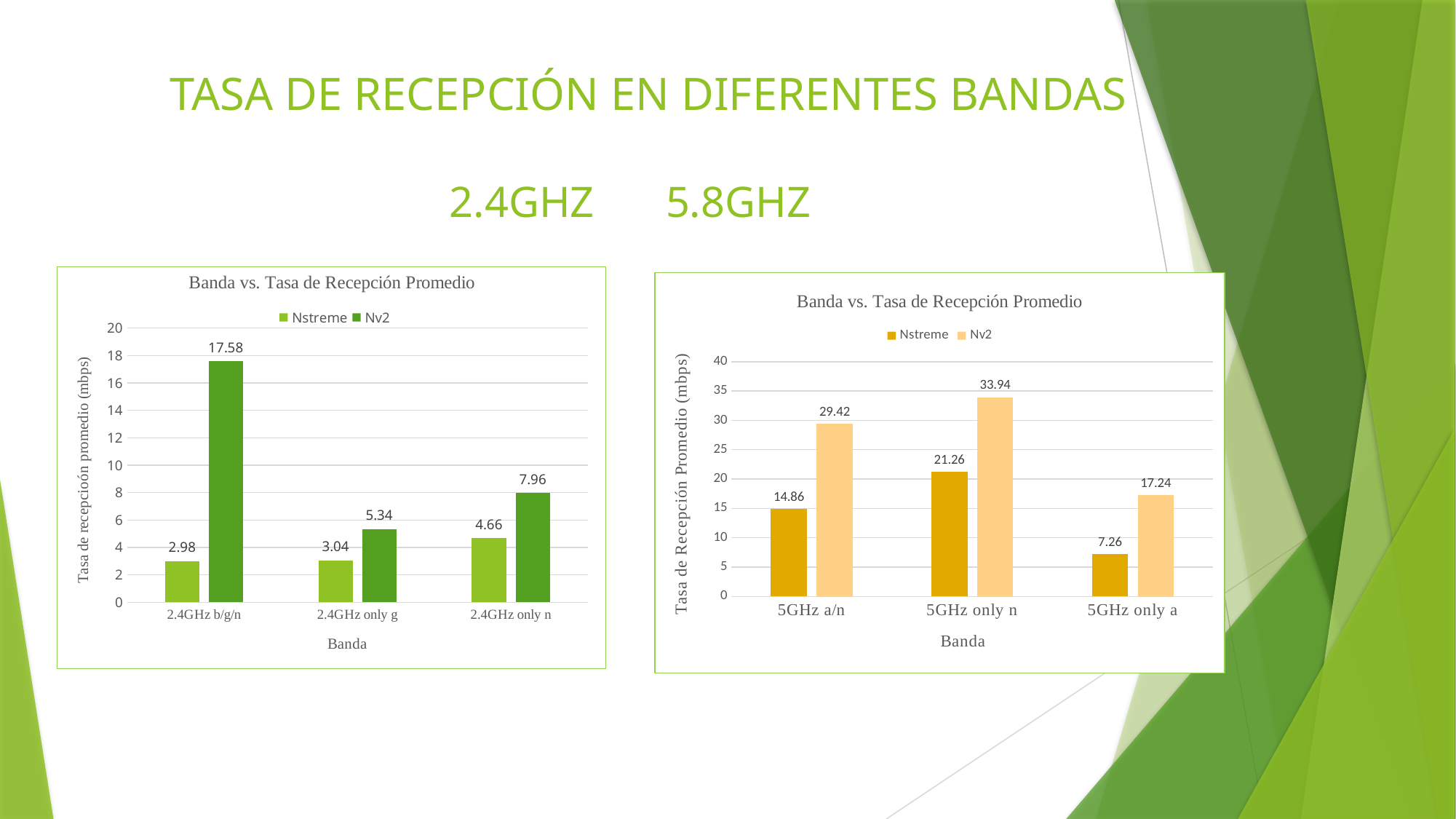
How many series does the legend of the right chart (5.8GHz) list? 2 In the left chart (2.4GHz), which category has the highest Nv2 value? 2.4GHz b/g/n What is the title of the right chart (5.8GHz)? Banda vs. Tasa de Recepción Promedio In the right chart (5.8GHz), which is larger: the Nstreme value for 5GHz a/n or the Nv2 value for 5GHz only a? Nv2 value for 5GHz only a In the right chart (5.8GHz), which category has the lowest Nstreme value? 5GHz only a In the right chart (5.8GHz), what is the Nstreme value for 5GHz only n? 21.26 How many categories are shown on the x axis of the left chart (2.4GHz)? 3 In the left chart (2.4GHz), what is the Nv2 value for 2.4GHz b/g/n? 17.58 In the right chart (5.8GHz), what is the difference between the Nv2 values for 5GHz only n and 5GHz a/n? 4.52 In the right chart (5.8GHz), what is the Nv2 value for 5GHz only a? 17.24 In the left chart (2.4GHz), what is the difference between the Nv2 and Nstreme values for 2.4GHz only n? 3.30 What kind of chart is the left chart (2.4GHz)? Bar chart